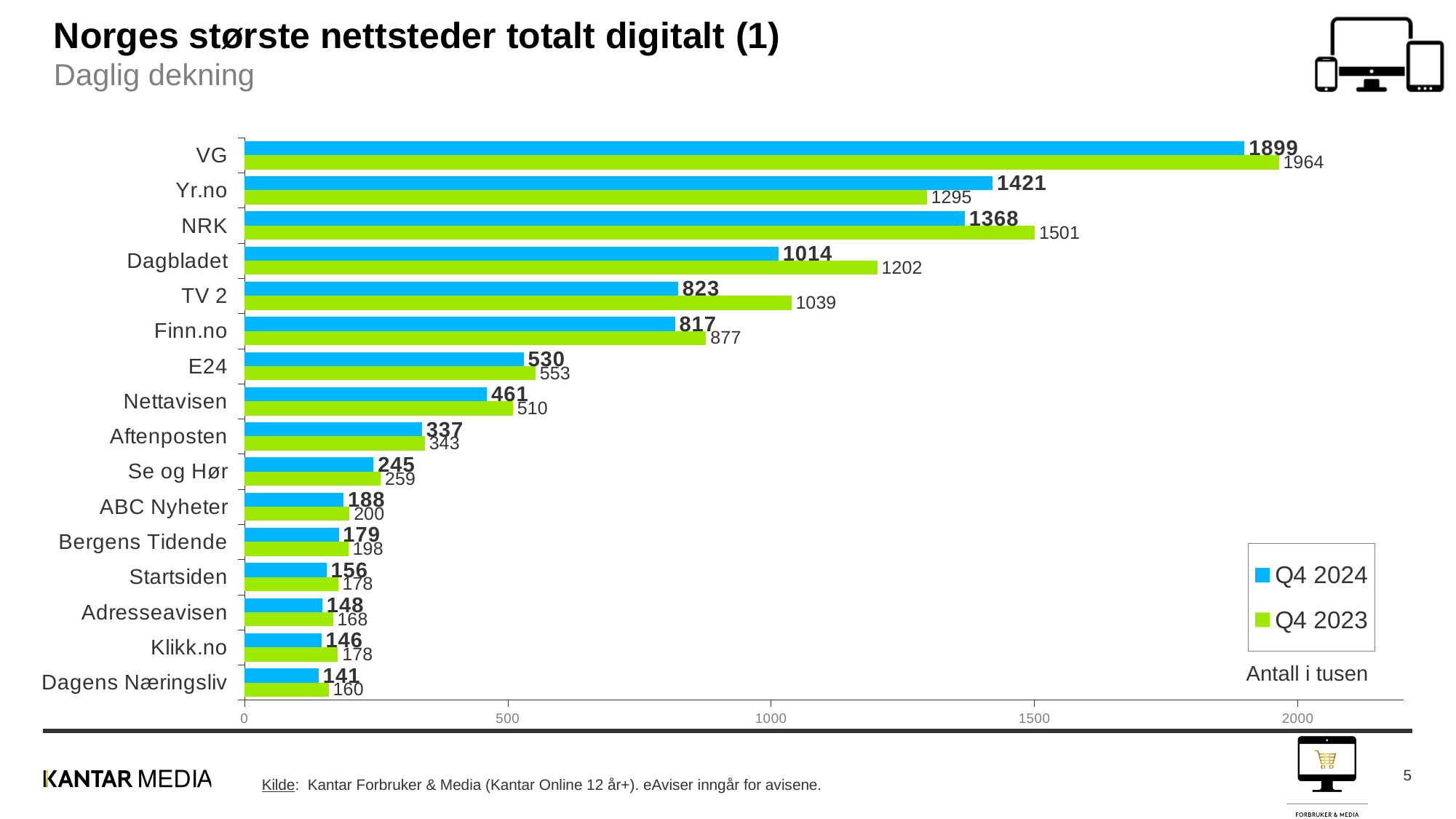
Is the Q4 2024 value for TV 2 greater or less than 1000? less What is the difference between the Q4 2023 and Q4 2024 values for Dagbladet? 188 What is the Q4 2024 value for VG? 1899 Which is larger for Yr.no: the Q4 2024 value or the Q4 2023 value? Q4 2024 How many series does the legend list? 2 How many websites are shown on the chart? 16 What unit is stated for the values on the chart? Antall i tusen Which website has the highest Q4 2024 value? VG Which website has the lowest Q4 2024 value? Dagens Næringsliv What kind of chart is shown on the slide? bar chart What is the Q4 2024 value for Nettavisen? 461 What is the Q4 2023 value for NRK? 1501